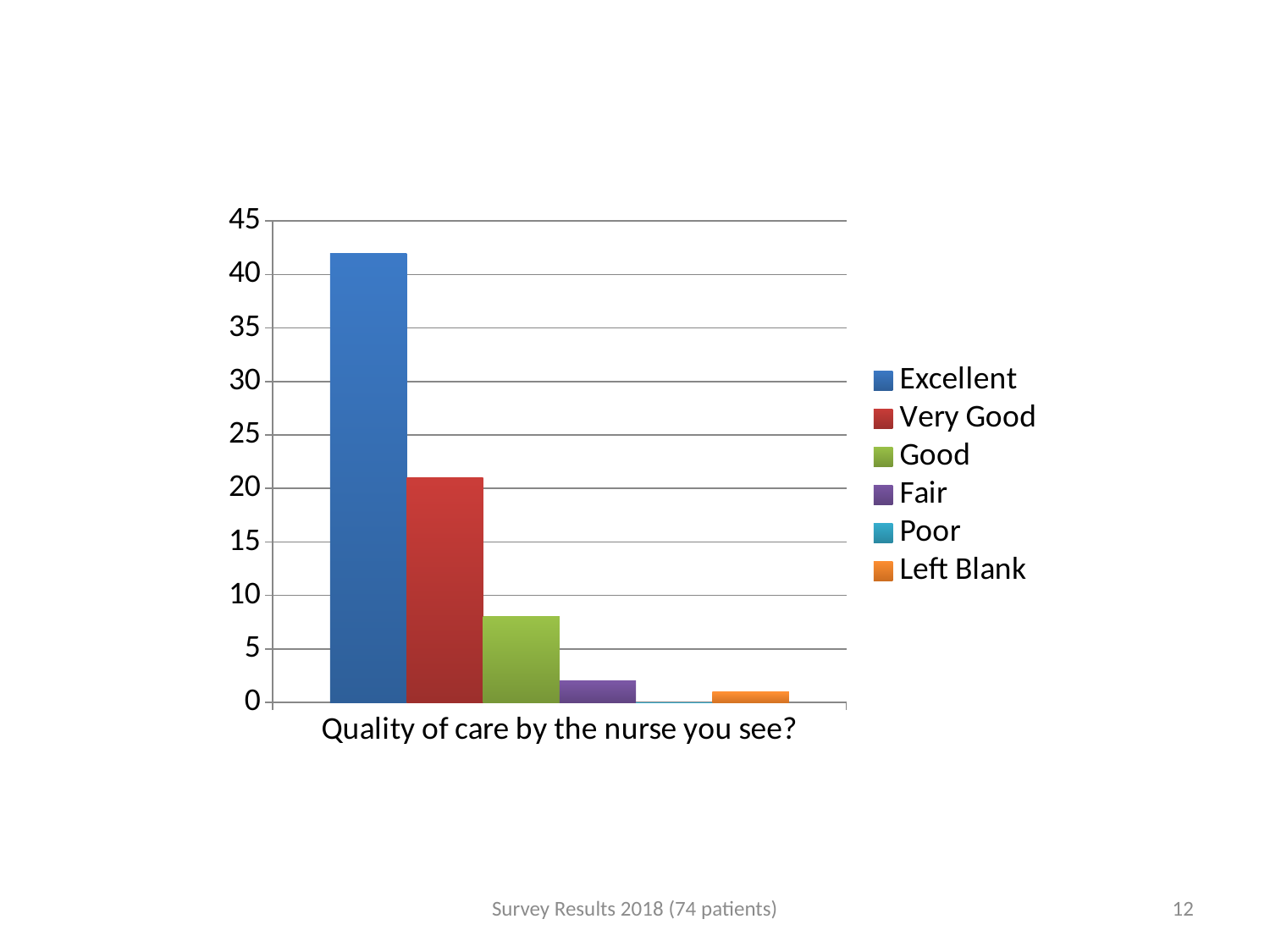
Which is larger, the value for Very Good or the value for Good? Very Good What kind of chart is shown on the slide? bar chart What question is shown as the category label beneath the chart? Quality of care by the nurse you see? Which category has the highest value in the chart? Excellent Is the value for Excellent greater or less than 40? greater Which category has the lowest value in the chart? Poor Is the value for Very Good greater or less than 15? greater Which is larger, the value for Fair or the value for Left Blank? Fair How many bars are plotted in the chart? 6 Is the value for Fair greater or less than 5? less How many entries does the legend list? 6